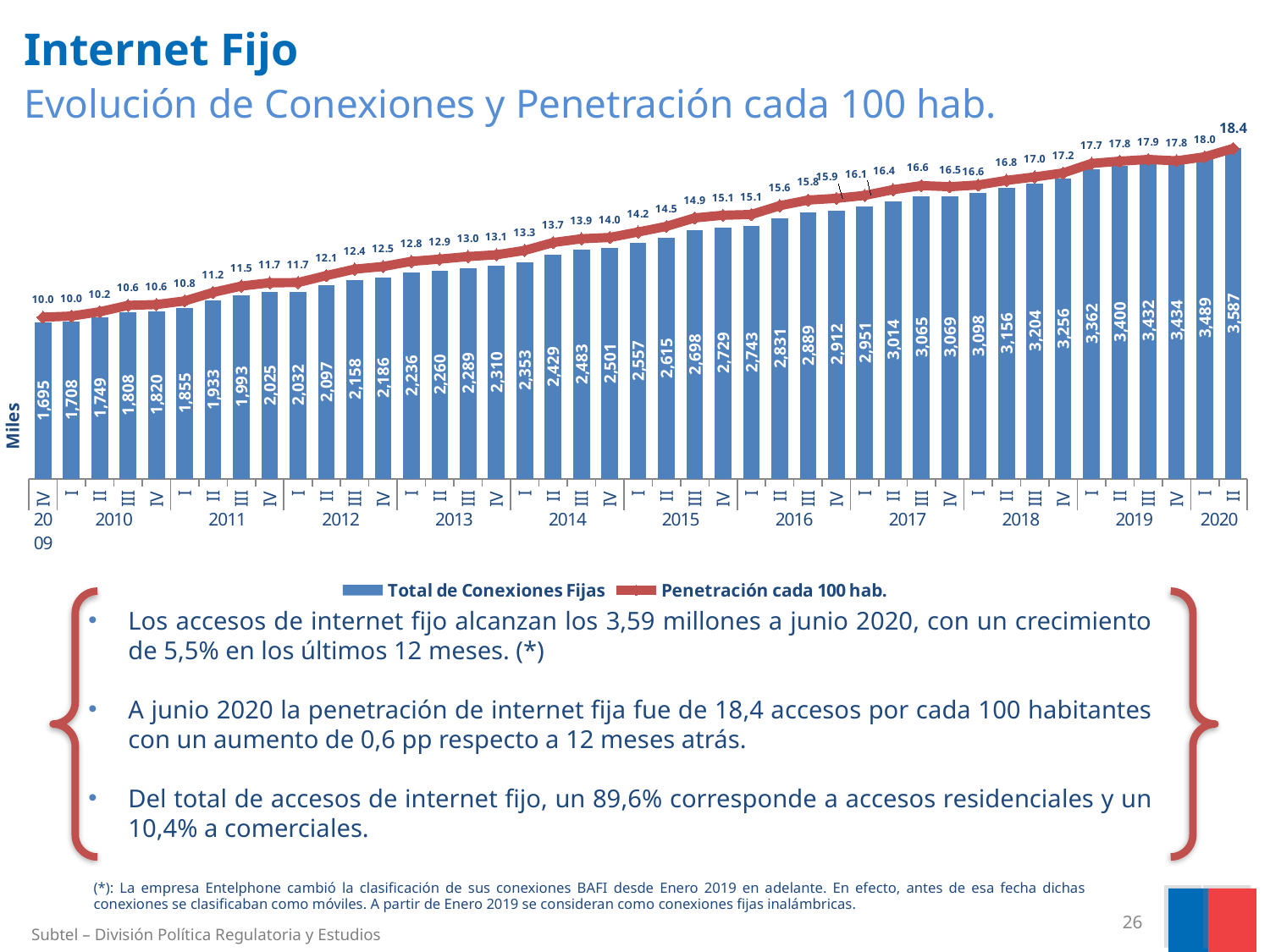
Which is larger, the Total de Conexiones Fijas for IV 2017 or for I 2018? I 2018 What is the overall trend of Total de Conexiones Fijas from IV 2009 to II 2020? Rising What is the Penetración cada 100 hab. value for II 2019? 17.8 What is the value of Total de Conexiones Fijas for II 2020? 3,587 What is the value of Total de Conexiones Fijas for IV 2014? 2,501 What is the difference in Penetración cada 100 hab. between II 2020 and II 2019? 0.6 Which quarter has the highest Total de Conexiones Fijas? II 2020 What is the Penetración cada 100 hab. value for IV 2009? 10.0 Which quarter has the lowest Total de Conexiones Fijas? IV 2009 How many quarters are plotted on the chart? 43 How many series does the legend list? 2 What is the difference in Total de Conexiones Fijas between II 2020 and II 2019? 187